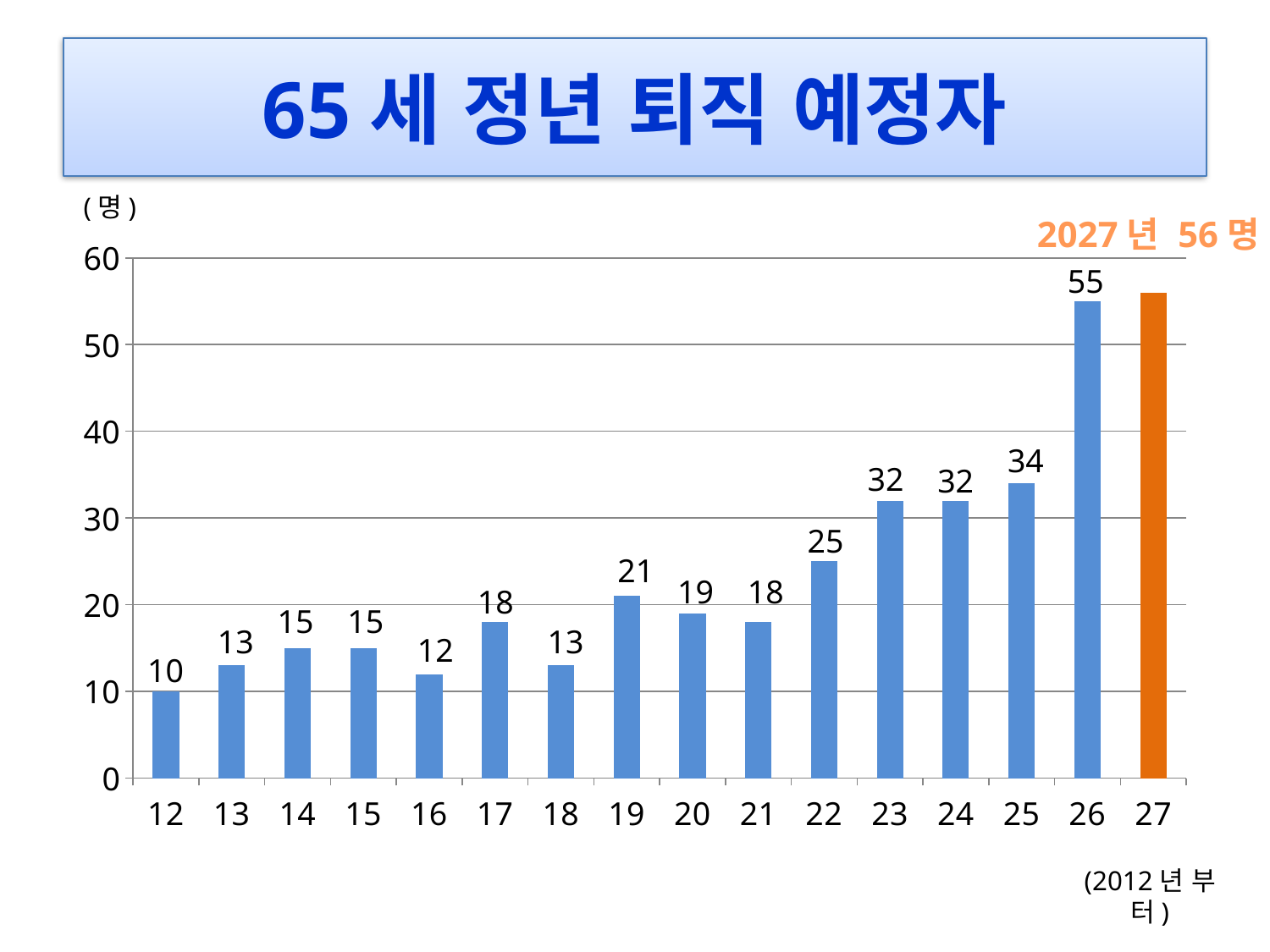
Which is larger, the value for 17 or the value for 18? 17 What is the title of the slide? 65 세 정년 퇴직 예정자 What is the value for 12 on the x axis? 10 Which category has the highest value? 27 What is the value for 26? 55 What is the difference between the values for 26 and 25? 21 What kind of chart is shown on the slide? bar chart Which category has the lowest value? 12 According to the annotation on the slide, how many people are expected in 2027? 56 명 How many categories are shown on the x axis? 16 Is the value for 25 greater or less than 30? greater What is the value for 22? 25